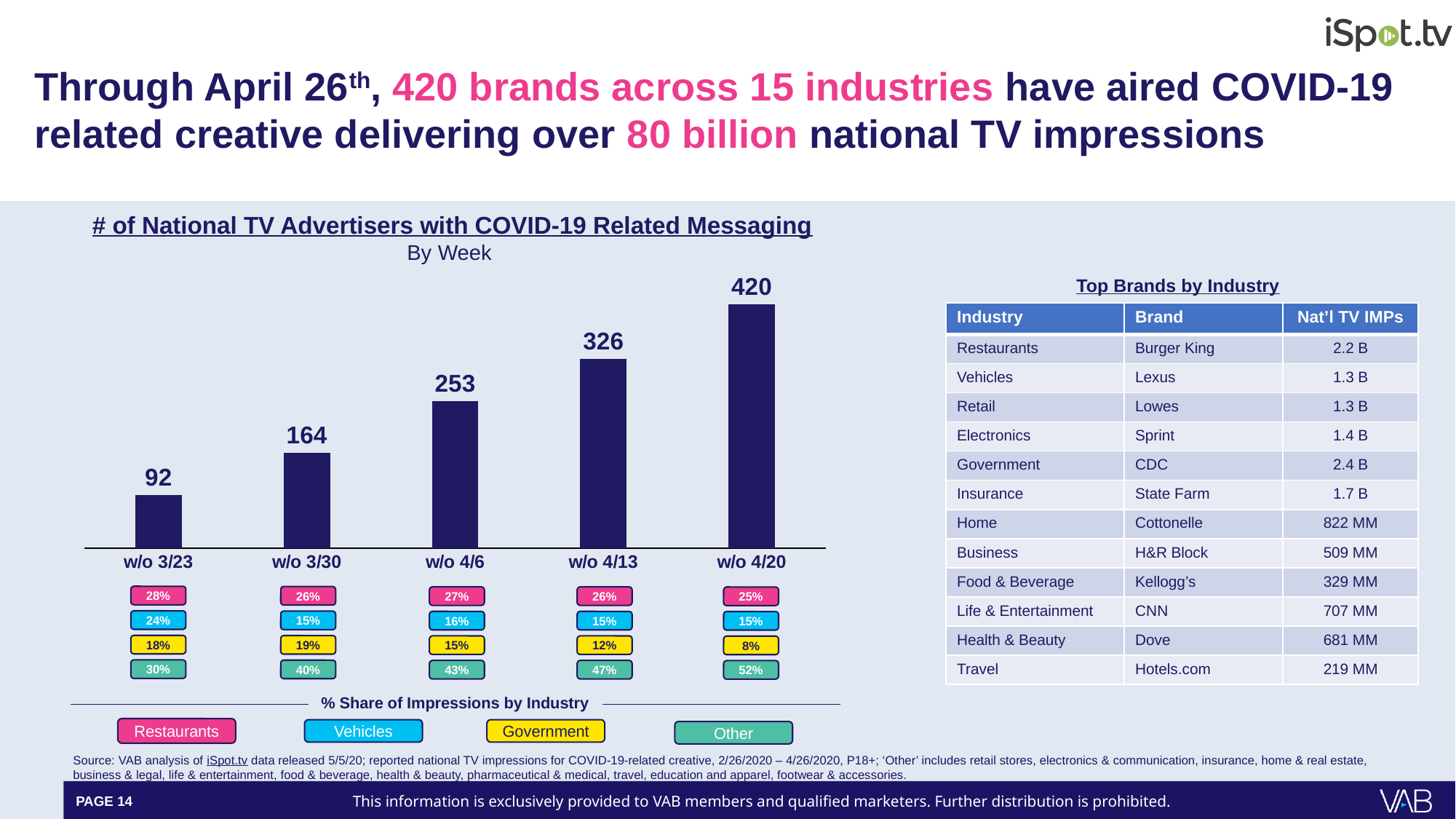
What is the % share of impressions for Restaurants in w/o 4/20? 25% How many industry categories are listed in the % Share of Impressions by Industry legend? 4 What is the difference in the number of advertisers between w/o 4/20 and w/o 4/13? 94 How many weeks are shown on the bar chart? 5 Which week has the highest number of national TV advertisers with COVID-19 related messaging? w/o 4/20 What is the difference in the number of advertisers between w/o 3/30 and w/o 3/23? 72 What is the number of national TV advertisers with COVID-19 related messaging for w/o 3/23? 92 Which week has more advertisers, w/o 3/30 or w/o 4/6? w/o 4/6 What type of chart is used to show the number of national TV advertisers by week? Bar chart What is the number of national TV advertisers with COVID-19 related messaging for w/o 4/6? 253 Do the number of advertisers rise or fall from w/o 3/23 to w/o 4/20? Rise Which week has the lowest number of national TV advertisers with COVID-19 related messaging? w/o 3/23